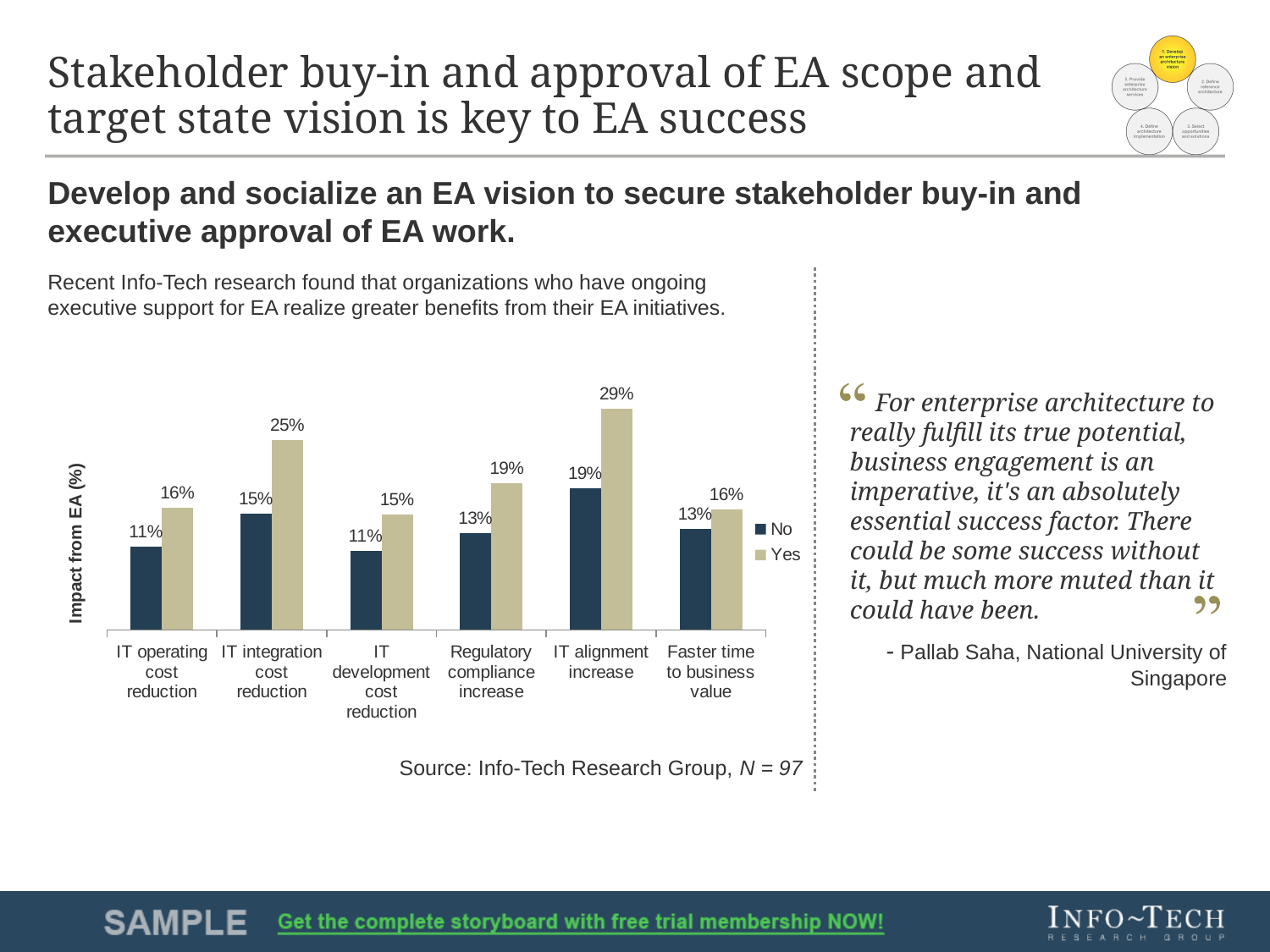
Which category has the lowest 'No' value? IT operating cost reduction and IT development cost reduction (both 11%) What are the two legend entries? No and Yes What is the 'No' value for IT integration cost reduction? 15% What is the 'Yes' value for Regulatory compliance increase? 19% Which category has the highest 'Yes' value? IT alignment increase What is the label of the y axis? Impact from EA (%) What is the difference between the 'Yes' and 'No' values for IT integration cost reduction? 10% Which is larger: the 'Yes' value for IT operating cost reduction or the 'Yes' value for IT integration cost reduction? IT integration cost reduction What is the 'Yes' value for IT alignment increase? 29% How many categories are shown on the x axis? 6 How many series does the legend list? 2 What kind of chart is shown on the slide? Bar chart